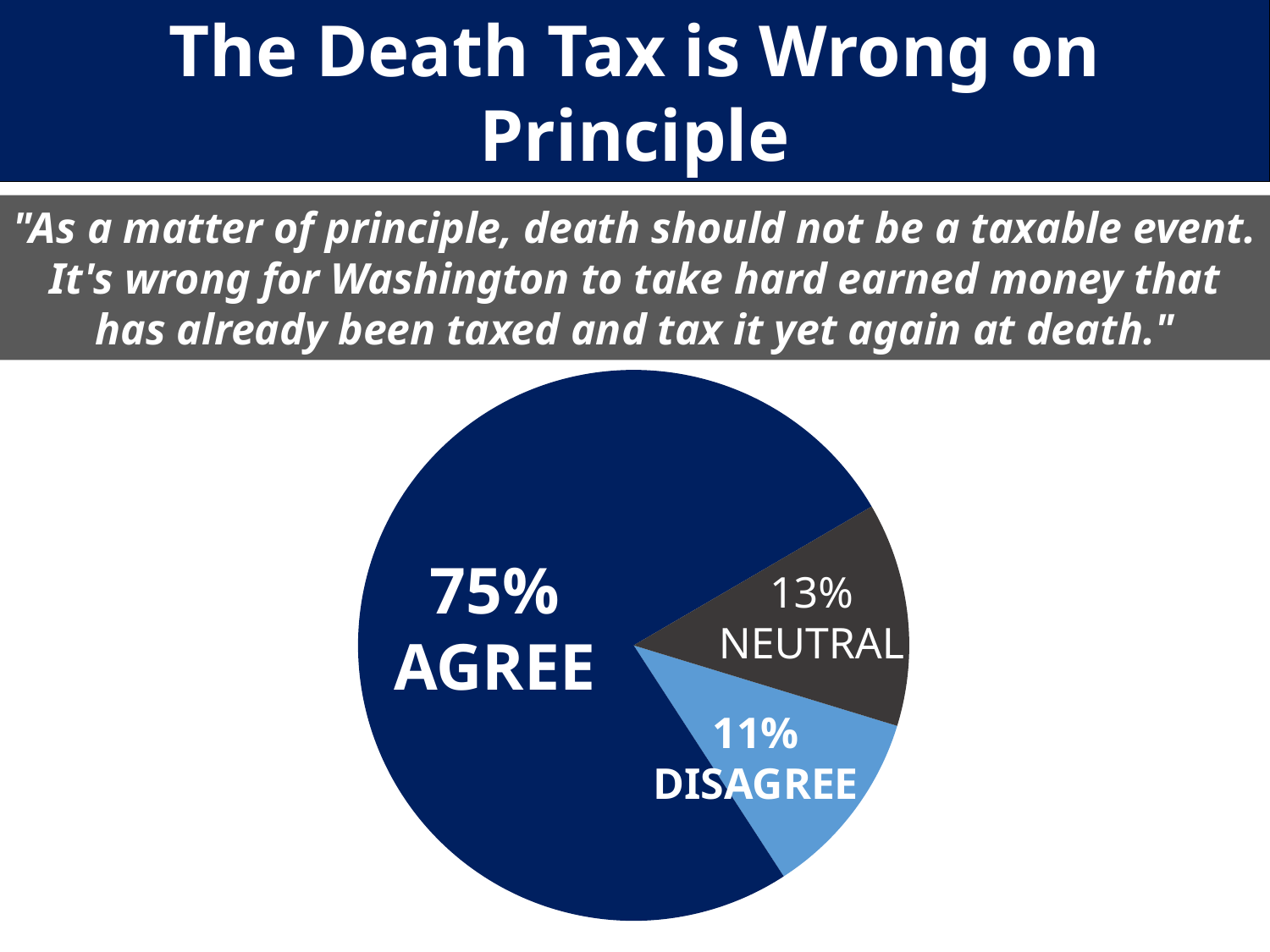
What colour is the Disagree slice? Light blue What percentage of respondents are neutral? 13% Which response has the largest share of the pie? Agree What percentage of respondents disagree? 11% How many slices does the pie chart have? 3 What kind of chart is shown on the slide? Pie chart Which response has the smallest share of the pie? Disagree What percentage of respondents agree? 75% What is the title of the slide containing the pie chart? The Death Tax is Wrong on Principle What is the difference in percentage points between Neutral and Disagree? 2 Which is larger, the Neutral share or the Disagree share? Neutral What is the difference in percentage points between Agree and Disagree? 64